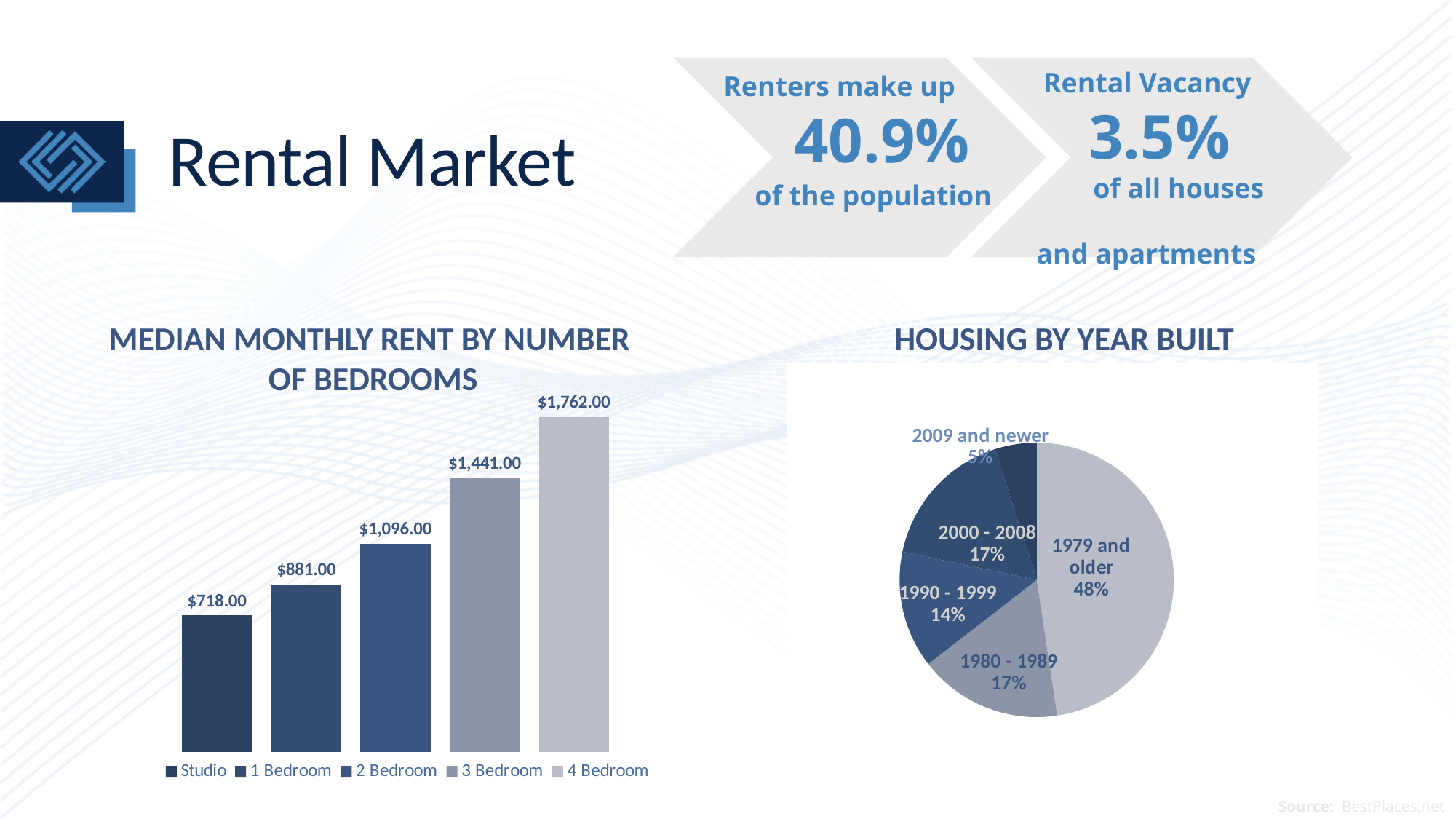
In the 'Housing by Year Built' chart, what share of housing was built in 1979 and older? 48% What kind of chart is 'Median Monthly Rent by Number of Bedrooms'? Bar chart In the 'Housing by Year Built' chart, which year-built category has the smallest share? 2009 and newer In the 'Housing by Year Built' chart, what share of housing was built in 1990 - 1999? 14% In the 'Median Monthly Rent by Number of Bedrooms' chart, which category has the lowest median monthly rent? Studio In the 'Median Monthly Rent by Number of Bedrooms' chart, do the values rise or fall as the number of bedrooms increases from Studio to 4 Bedroom? Rise In the 'Median Monthly Rent by Number of Bedrooms' chart, which category has the highest median monthly rent? 4 Bedroom In the 'Median Monthly Rent by Number of Bedrooms' chart, what is the difference between the 3 Bedroom and 1 Bedroom median rents? $560.00 In the 'Median Monthly Rent by Number of Bedrooms' chart, how many bedroom categories are shown? 5 What kind of chart is 'Housing by Year Built'? Pie chart In the 'Median Monthly Rent by Number of Bedrooms' chart, what is the median monthly rent for a 2 Bedroom? $1,096.00 In the 'Median Monthly Rent by Number of Bedrooms' chart, what is the median monthly rent for a Studio? $718.00